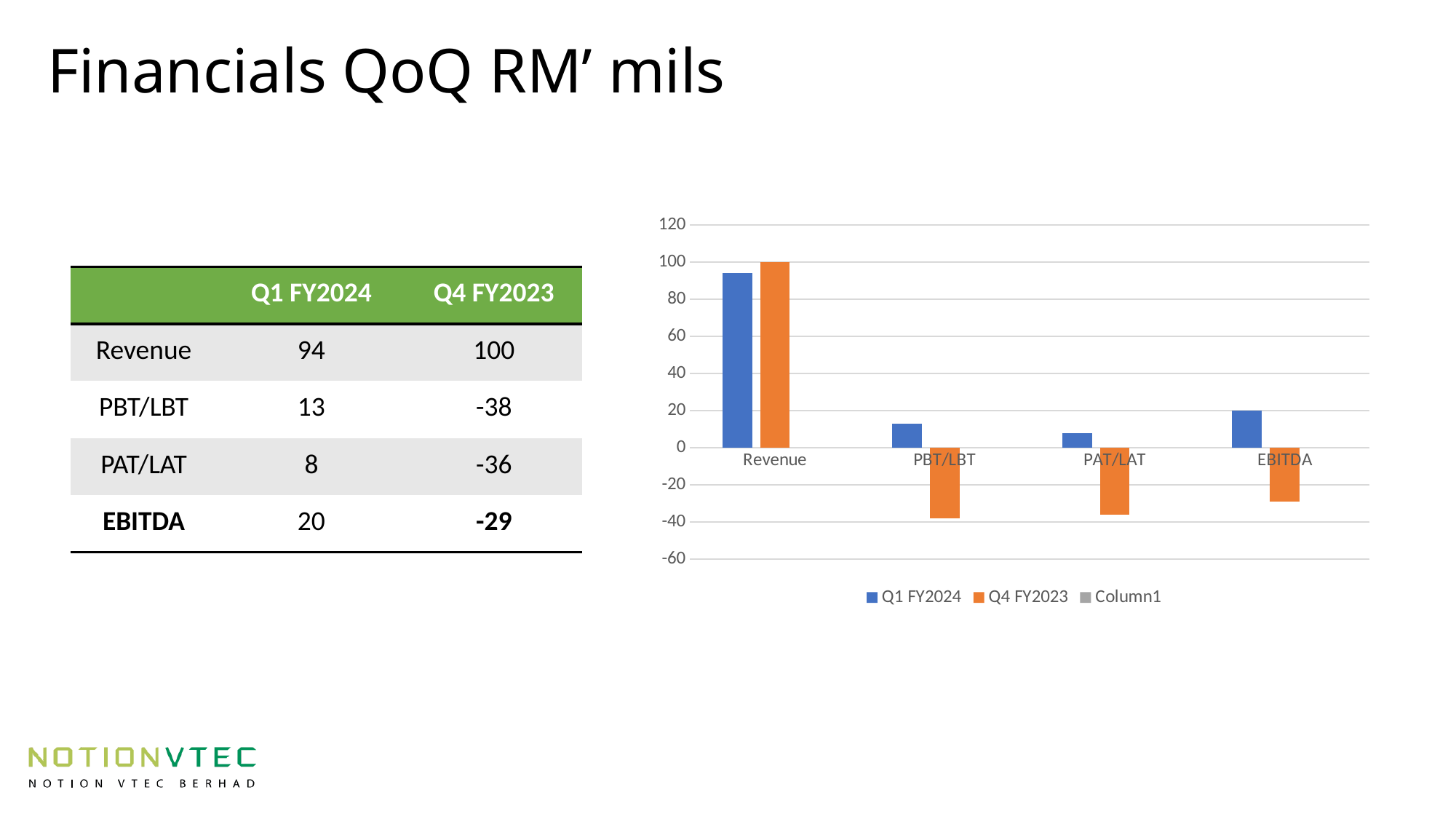
What kind of chart is shown on the slide? bar chart What is the Q4 FY2023 value for PBT/LBT? -38 What is the Q1 FY2024 value for EBITDA? 20 Which colour represents the Q4 FY2023 series in the chart? orange Which category has the lowest Q4 FY2023 value? PBT/LBT What is the Q4 FY2023 value for Revenue? 100 Which is larger for PAT/LAT: the Q1 FY2024 value or the Q4 FY2023 value? Q1 FY2024 Which category has the highest Q1 FY2024 value? Revenue How many series does the chart legend list? 3 Is the Q1 FY2024 value for Revenue greater or less than 80? greater What is the difference between the Q4 FY2023 and Q1 FY2024 values for Revenue? 6 How many categories are shown on the x axis of the chart? 4